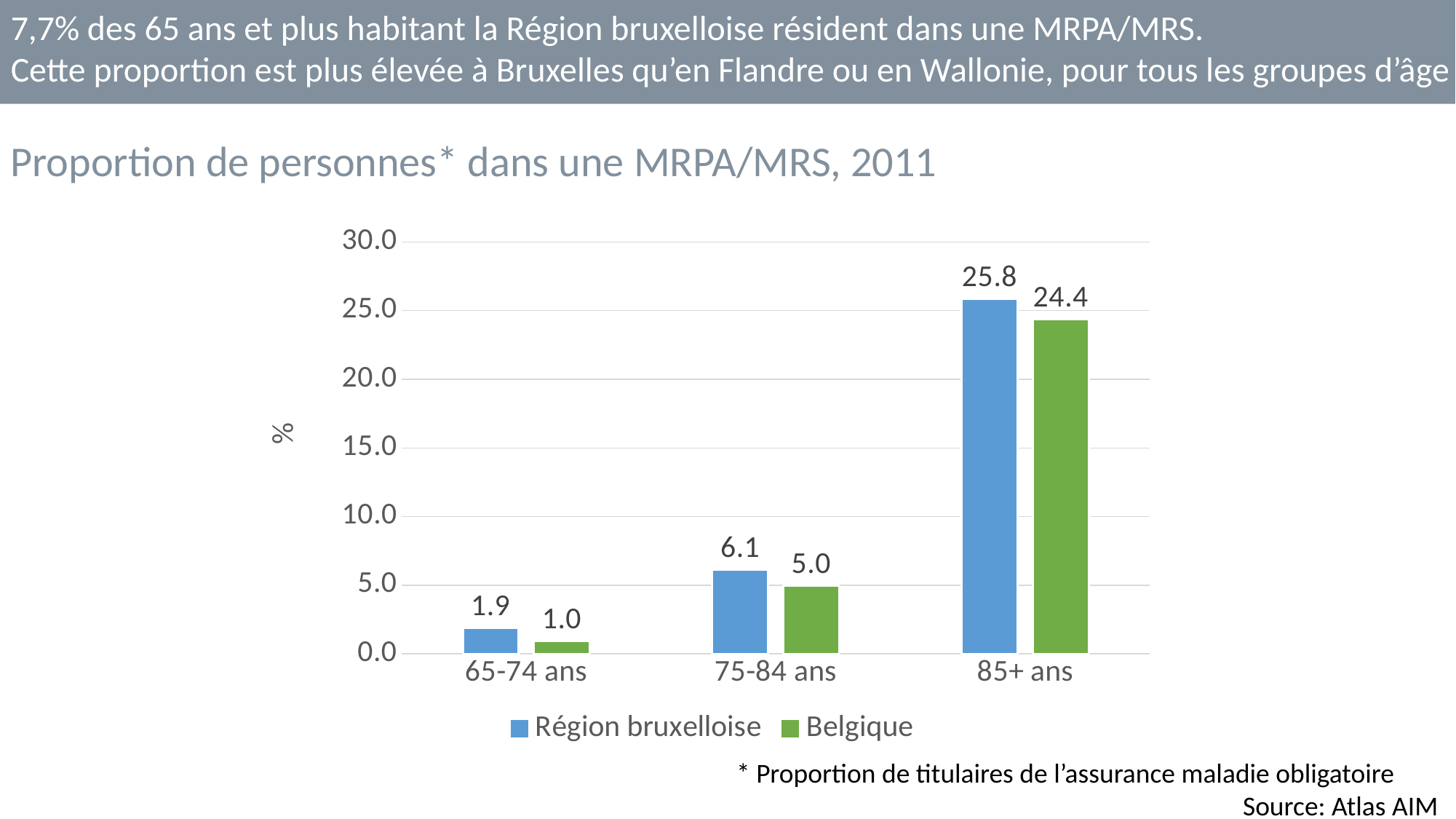
Which age group has the lowest value for Belgique? 65-74 ans How many series does the legend list? 2 How many age groups are shown on the x axis? 3 What is the difference between Région bruxelloise and Belgique in the 75-84 ans age group? 1.1 Is the value for Belgique in the 85+ ans age group greater or less than 20.0? greater What kind of chart is shown on the slide? Bar chart Which age group has the highest value for Région bruxelloise? 85+ ans What is the value for Région bruxelloise in the 85+ ans age group? 25.8 What is the difference between Région bruxelloise and Belgique in the 85+ ans age group? 1.4 Which is larger in the 65-74 ans age group: Région bruxelloise or Belgique? Région bruxelloise What is the value for Belgique in the 75-84 ans age group? 5.0 What is the value for Belgique in the 65-74 ans age group? 1.0